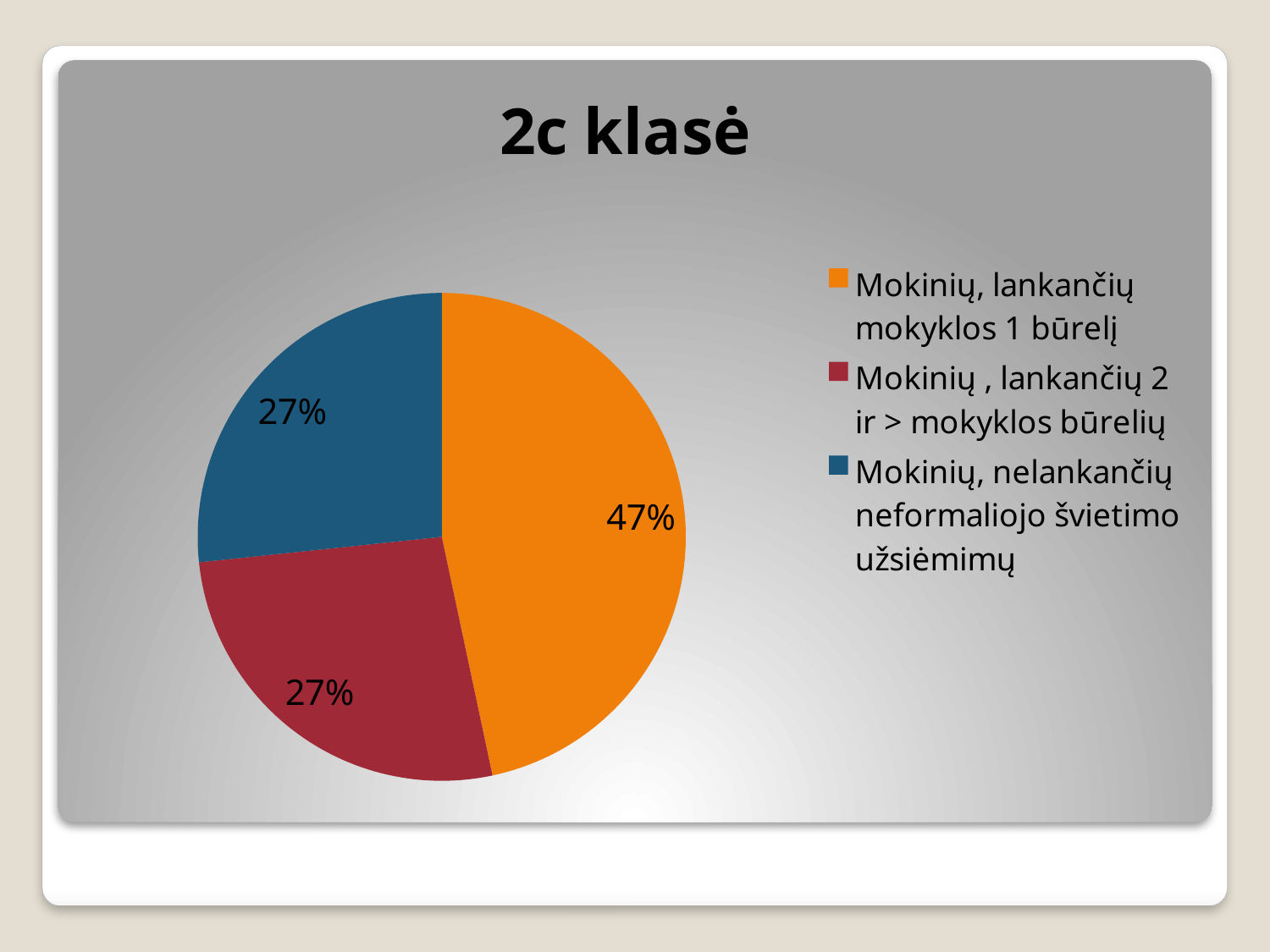
Is the share for "Mokinių, lankančių mokyklos 1 būrelį" greater or less than 50%? less What is the difference in percentage points between the "Mokinių, lankančių mokyklos 1 būrelį" slice and the "Mokinių, nelankančių neformaliojo švietimo užsiėmimų" slice? 20 percentage points What share of the pie is labelled for "Mokinių , lankančių 2 ir > mokyklos būrelių"? 27% What share of the pie is labelled for "Mokinių, nelankančių neformaliojo švietimo užsiėmimų"? 27% What colour is the slice for "Mokinių, nelankančių neformaliojo švietimo užsiėmimų"? blue Which category has the largest slice of the pie? Mokinių, lankančių mokyklos 1 būrelį What share of the pie is labelled for "Mokinių, lankančių mokyklos 1 būrelį"? 47% Which is larger: the slice for "Mokinių, lankančių mokyklos 1 būrelį" or the slice for "Mokinių , lankančių 2 ir > mokyklos būrelių"? Mokinių, lankančių mokyklos 1 būrelį What type of chart is shown on the slide? pie chart How many slices does the pie chart have? 3 How many entries does the legend list? 3 What is the title of the chart? 2c klasė